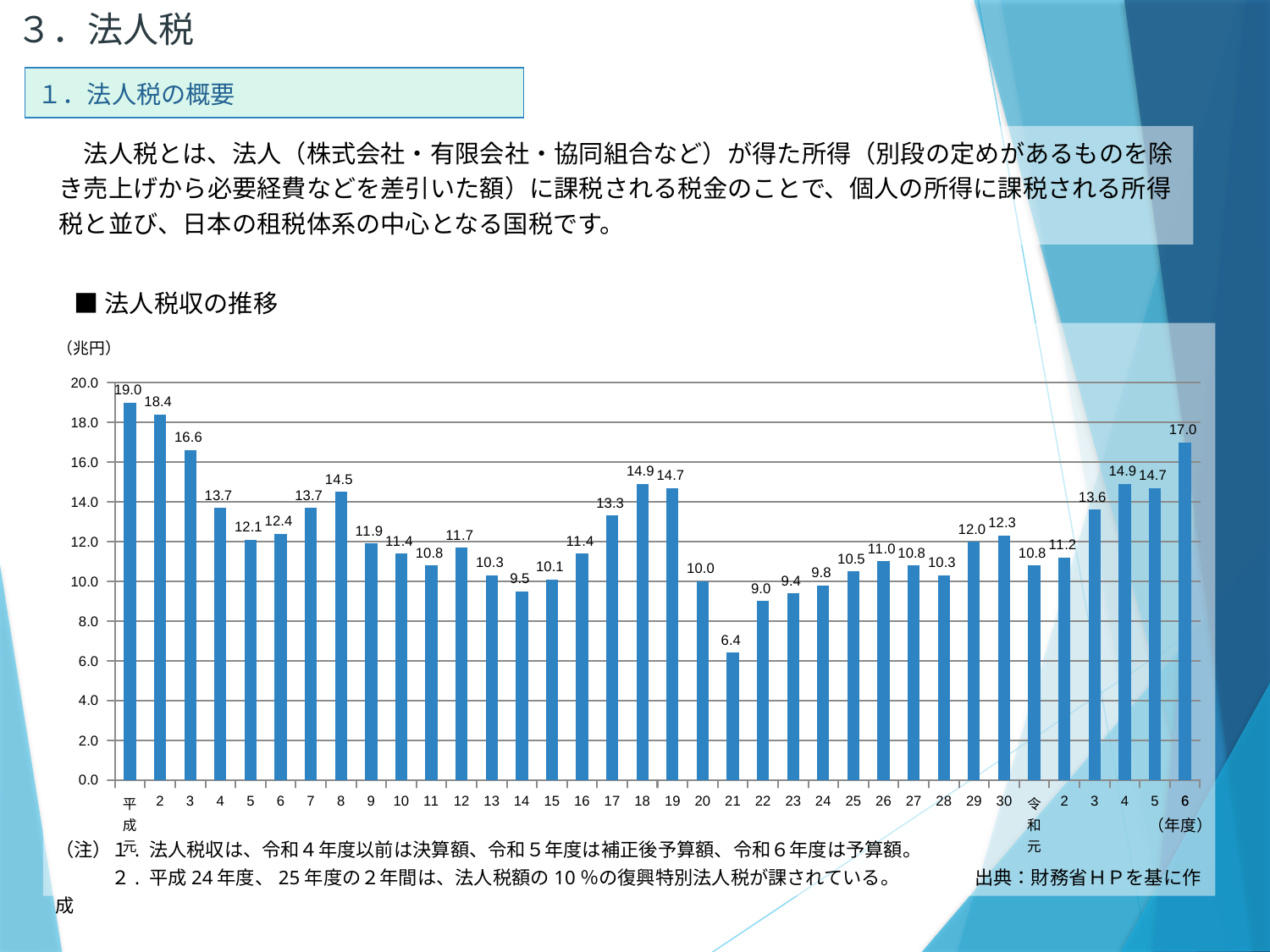
「法人税収の推移」のグラフで、法人税収が最も高い年度はどれですか？ 平成元年度 「法人税収の推移」のグラフの縦軸の単位は何ですか？ 兆円 「法人税収の推移」のグラフには、何年度分の棒がありますか？ 36 「法人税収の推移」のグラフで、平成元年度と平成2年度の差はいくらですか？ 0.6 「法人税収の推移」のグラフで、法人税収が最も低い年度はどれですか？ 平成21年度 「法人税収の推移」のグラフで、平成3年度と令和6年度ではどちらの値が大きいですか？ 令和6年度 「法人税収の推移」のグラフはどの種類のグラフですか？ 棒グラフ 「法人税収の推移」のグラフで、令和6年度と令和5年度の差はいくらですか？ 2.3 「法人税収の推移」のグラフで、平成18年度の値はいくらですか？ 14.9 「法人税収の推移」のグラフで、平成21年度の法人税収はいくらですか？ 6.4 「法人税収の推移」のグラフで、平成20年度と平成22年度ではどちらの値が大きいですか？ 平成20年度 「法人税収の推移」のグラフで、令和6年度の法人税収はいくらですか？ 17.0